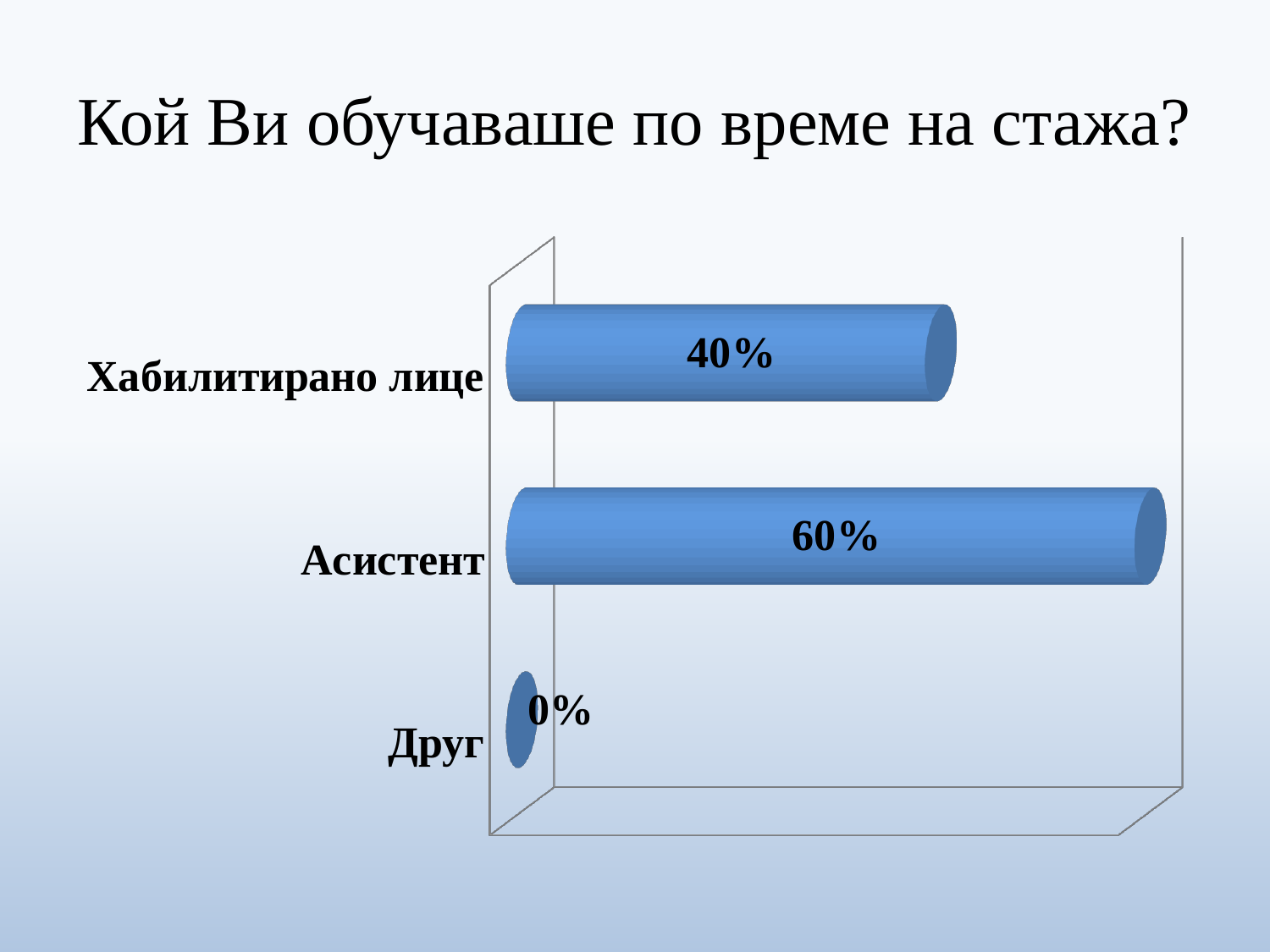
What is the value for Хабилитирано лице? 40% What kind of chart is shown on the slide? Bar chart Which is larger, the value for Хабилитирано лице or the value for Асистент? Асистент What is the value for Друг? 0% What is the difference between the values for Хабилитирано лице and Друг? 40% What colour are the bars in the chart? Blue Which category has the lowest value? Друг What is the title of the slide? Кой Ви обучаваше по време на стажа? What is the difference between the values for Асистент and Хабилитирано лице? 20% How many categories are shown in the chart? 3 What is the value for Асистент? 60% Which category has the highest value? Асистент